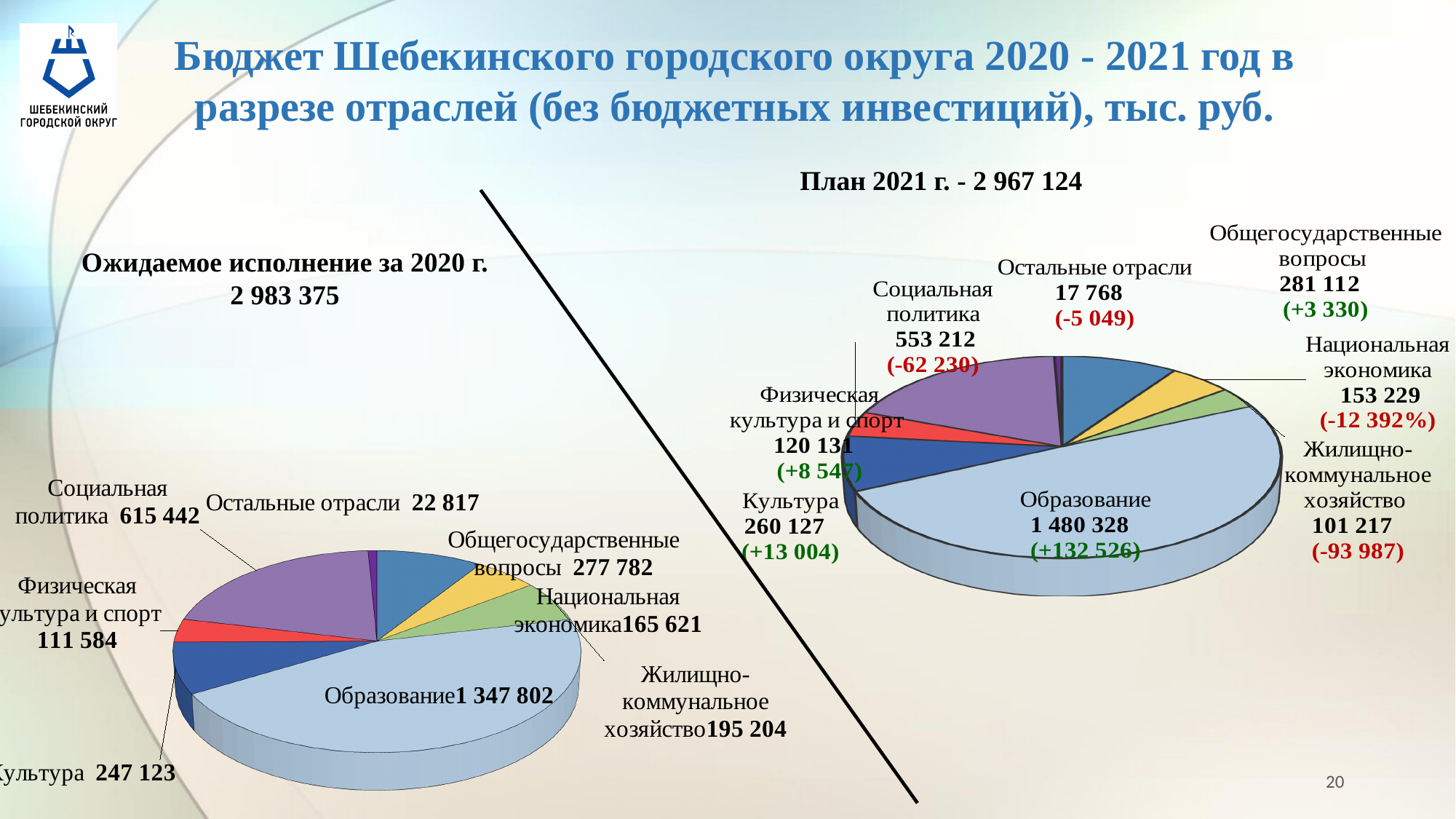
In the 2021 chart (План 2021 г.), which category has the smallest value? Остальные отрасли In the 2020 chart (Ожидаемое исполнение за 2020 г.), what is the value for Образование? 1 347 802 What is the total shown for the 2020 chart (Ожидаемое исполнение за 2020 г.)? 2 983 375 What is the total shown for the 2021 chart (План 2021 г.)? 2 967 124 In the 2020 chart (Ожидаемое исполнение за 2020 г.), which is larger: Культура or Жилищно-коммунальное хозяйство? Культура In the 2021 chart (План 2021 г.), what is the value for Жилищно-коммунальное хозяйство? 101 217 How many categories (slices) does the 2021 chart (План 2021 г.) have? 8 How much larger is the value for Образование in the 2021 chart than in the 2020 chart? 132 526 In the 2021 chart (План 2021 г.), what is the value for Социальная политика? 553 212 In the 2020 chart (Ожидаемое исполнение за 2020 г.), which category has the largest value? Образование In the 2020 chart (Ожидаемое исполнение за 2020 г.), what is the difference between Общегосударственные вопросы and Национальная экономика? 112 161 What type of charts are shown on the slide? Pie charts